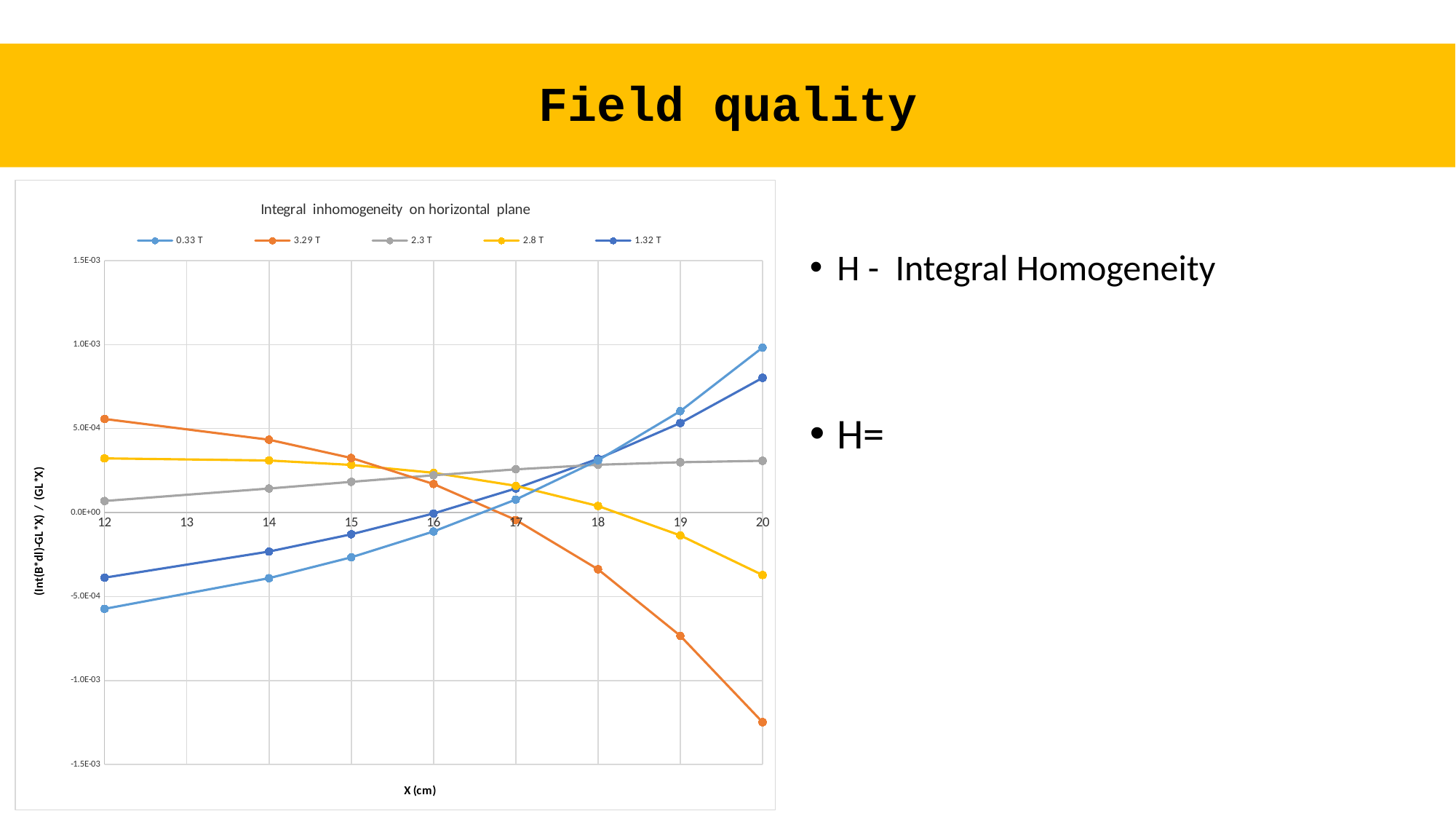
What is the title of the chart? Integral inhomogeneity on horizontal plane Which series has the highest value at X = 12? 3.29 T Does the 3.29 T series rise or fall as X increases from 12 to 20? fall How many series does the legend of the chart list? 5 Is the value of the 0.33 T series at X = 20 greater or less than 5.0E-04? greater At X = 20, which series has the larger value, 0.33 T or 1.32 T? 0.33 T What is the label of the x axis of the chart? X (cm) What kind of chart is shown on the slide? line chart Is the value of the 3.29 T series at X = 20 greater or less than -1.0E-03? less Which series has the lowest value at X = 20? 3.29 T Does the 0.33 T series rise or fall as X increases from 12 to 20? rise Is the value of the 3.29 T series at X = 12 greater or less than 0.0E+00? greater